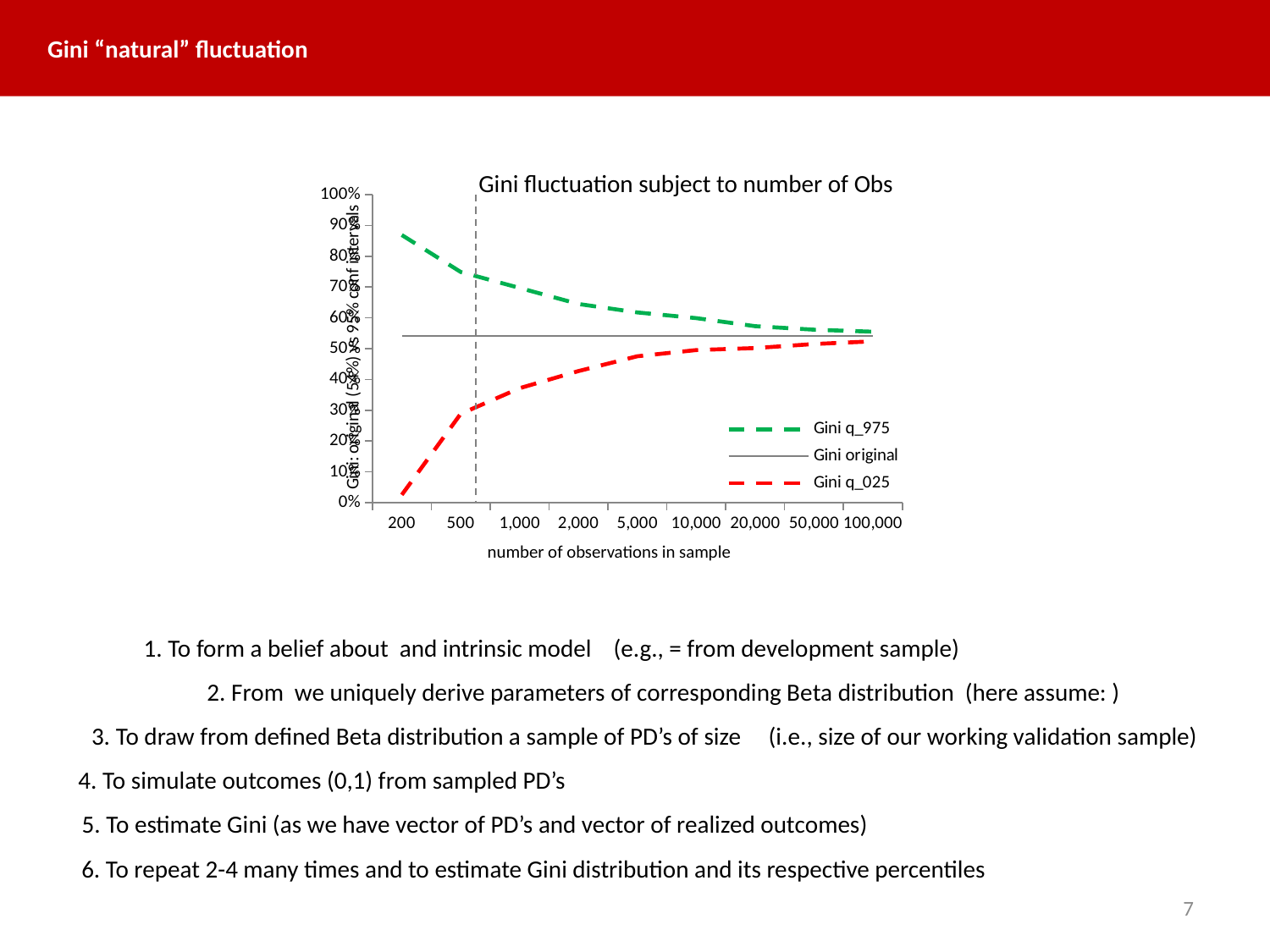
How many tick labels are shown on the x axis (number of observations in sample)? 9 What is the title of the chart? Gini fluctuation subject to number of Obs Is the value of Gini q_975 at 200 observations greater or less than 80%? greater Does the Gini q_975 series rise or fall as the number of observations increases? fall What kind of chart is shown on the slide? line chart Is the value of Gini original greater or less than 50%? greater Which series has the highest value at 200 observations? Gini q_975 Is the value of Gini q_025 at 200 observations greater or less than 10%? less How many series does the legend list? 3 Which series has the lowest value at 200 observations? Gini q_025 Does the Gini q_025 series rise or fall as the number of observations increases? rise What is the label of the x axis? number of observations in sample